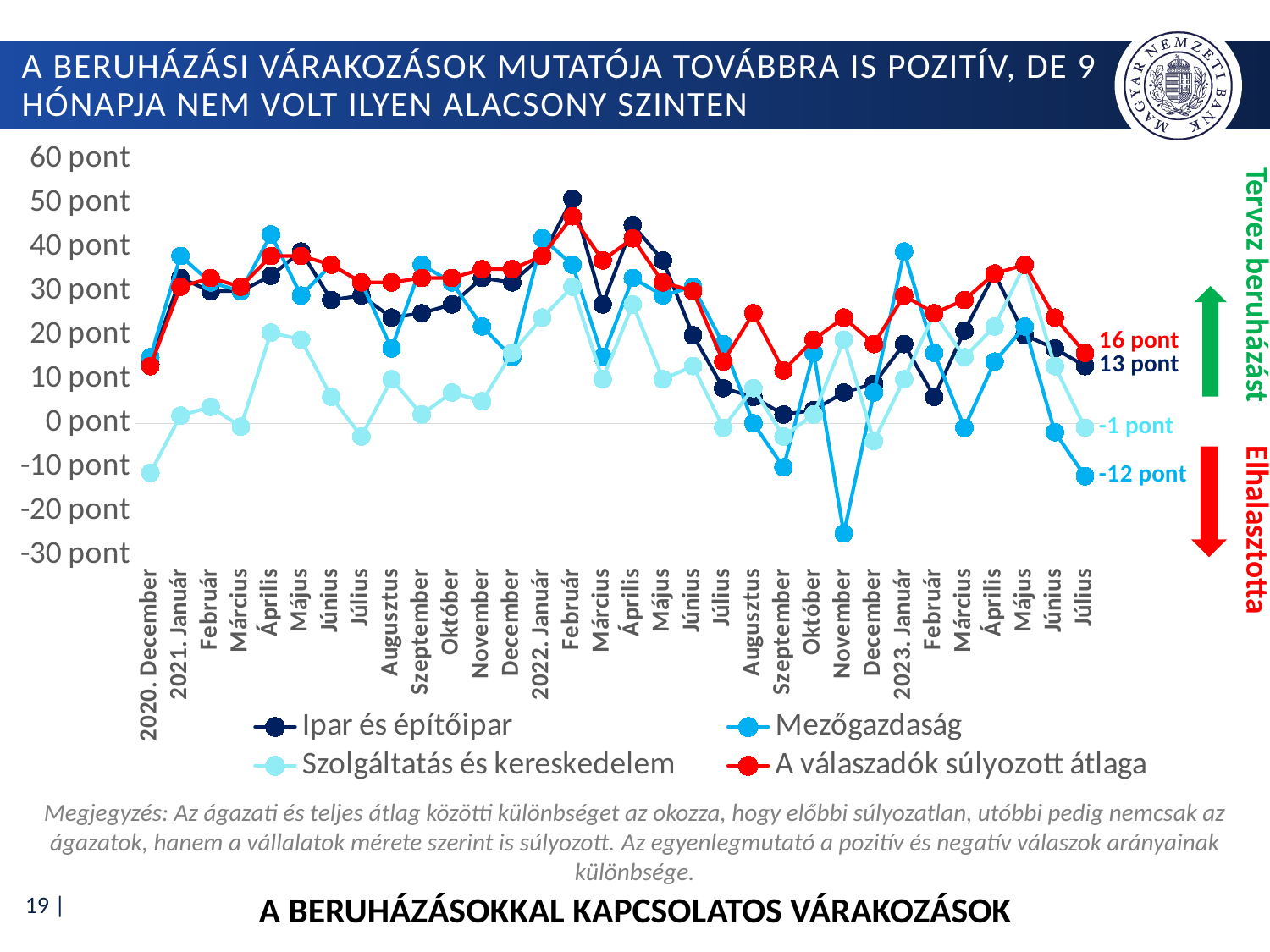
What is the value of 'Ipar és építőipar' for 2023 Július? 13 pont How many series does the legend list? 4 What is the difference between 'Szolgáltatás és kereskedelem' and 'Mezőgazdaság' in 2023 Július? 11 pont Which series is drawn in red in the legend? A válaszadók súlyozott átlaga What type of chart is shown on the slide? line chart Is the value for 'Ipar és építőipar' in 2022 Február greater or less than 40 pont? greater What is the value of 'A válaszadók súlyozott átlaga' for 2023 Július? 16 pont Which series has the lowest value in 2023 Július? Mezőgazdaság What is the difference between 'A válaszadók súlyozott átlaga' and 'Ipar és építőipar' in 2023 Július? 3 pont What is the value of 'Mezőgazdaság' for 2023 Július? -12 pont Is the value for 'Mezőgazdaság' in 2022 November greater or less than -20 pont? less What is the value of 'Szolgáltatás és kereskedelem' for 2023 Július? -1 pont